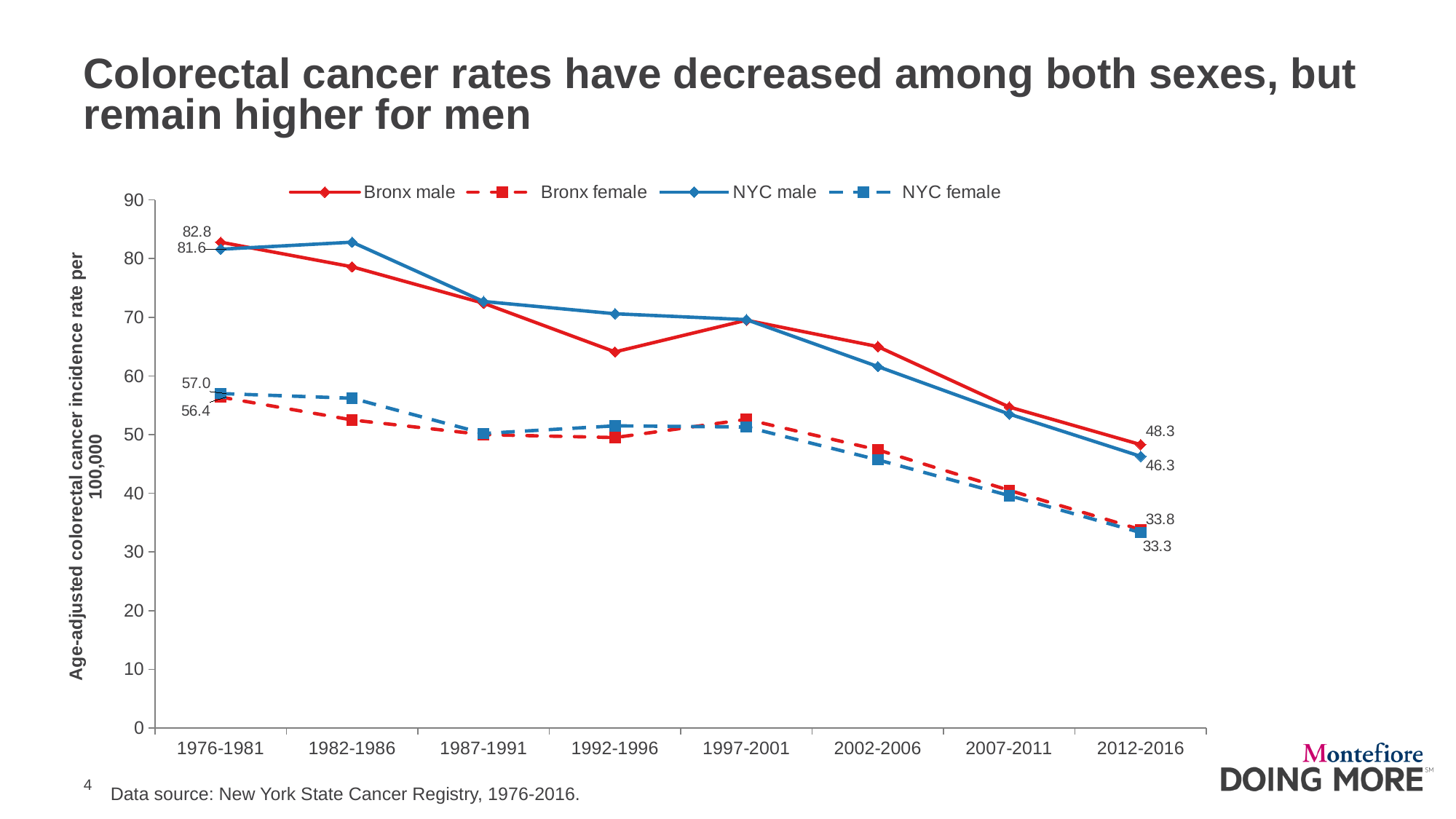
What is the NYC male rate for 2012-2016? 46.3 Is the Bronx male rate for 1992-1996 greater or less than 60? greater How many time periods are shown on the x axis? 8 Does the NYC male rate rise or fall from 1982-1986 to 2012-2016? fall What is the Bronx female rate for 2012-2016? 33.8 What type of chart is shown on the slide? line chart Which is larger in 1976-1981, the NYC female rate or the Bronx female rate? NYC female What is the Bronx male rate for 1976-1981? 82.8 How many series does the legend list? 4 By how much did the Bronx male rate fall from 1976-1981 to 2012-2016? 34.5 What is the difference between the Bronx male and NYC male rates in 2012-2016? 2.0 What is the NYC female rate for 1976-1981? 57.0